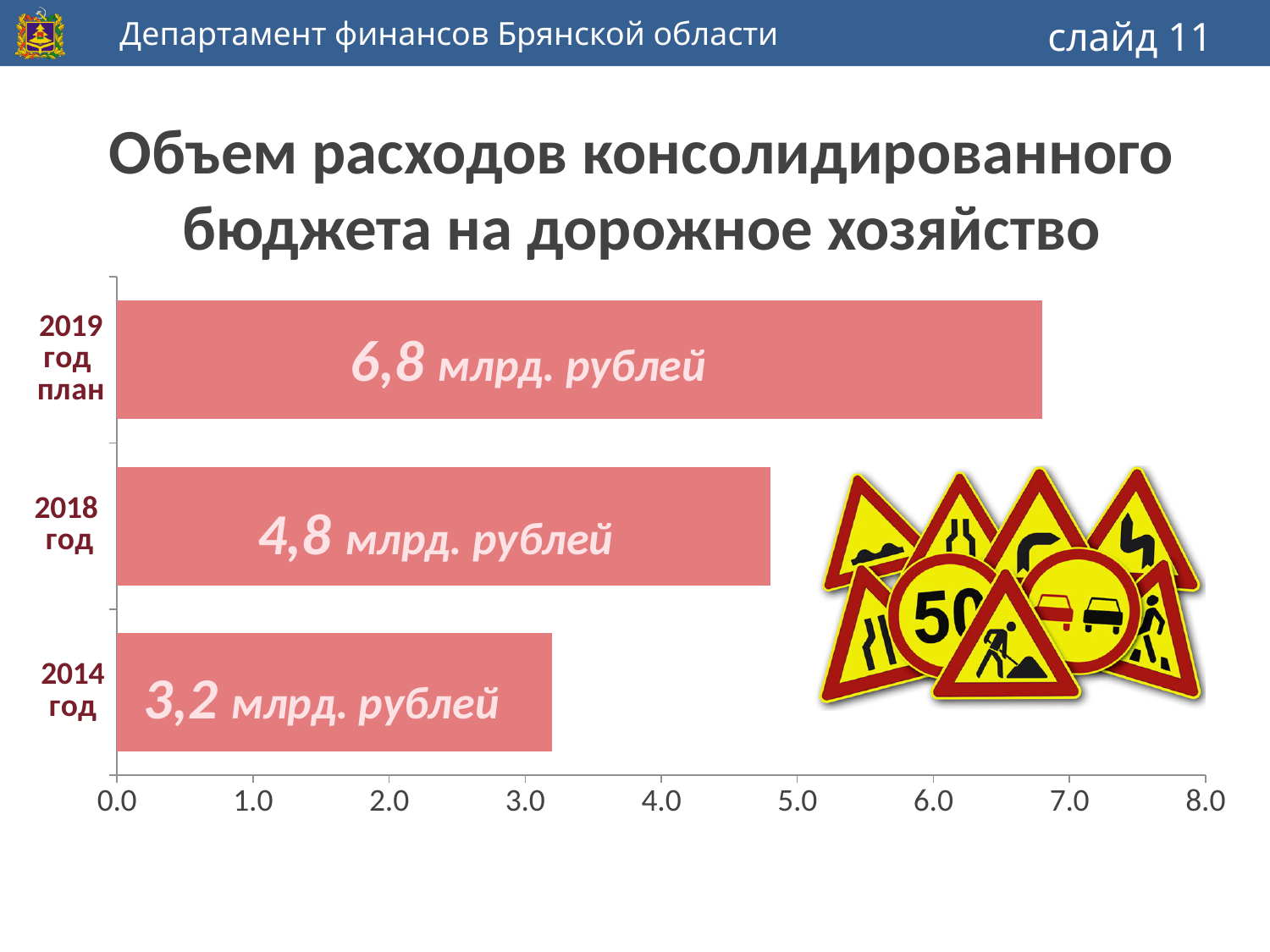
What is the title of the chart? Объем расходов консолидированного бюджета на дорожное хозяйство Which category has the highest value? 2019 год план What is the value for 2018 год? 4,8 млрд. рублей What is the value for 2019 год план? 6,8 млрд. рублей Which category has the lowest value? 2014 год Is the value for 2018 год greater or less than 4.0? greater What is the difference between the values for 2018 год and 2014 год? 1,6 млрд. рублей What kind of chart is shown on the slide? bar chart Which is larger, the value for 2018 год or the value for 2014 год? 2018 год What is the difference between the values for 2019 год план and 2014 год? 3,6 млрд. рублей What is the value for 2014 год? 3,2 млрд. рублей How many categories are shown in the chart? 3